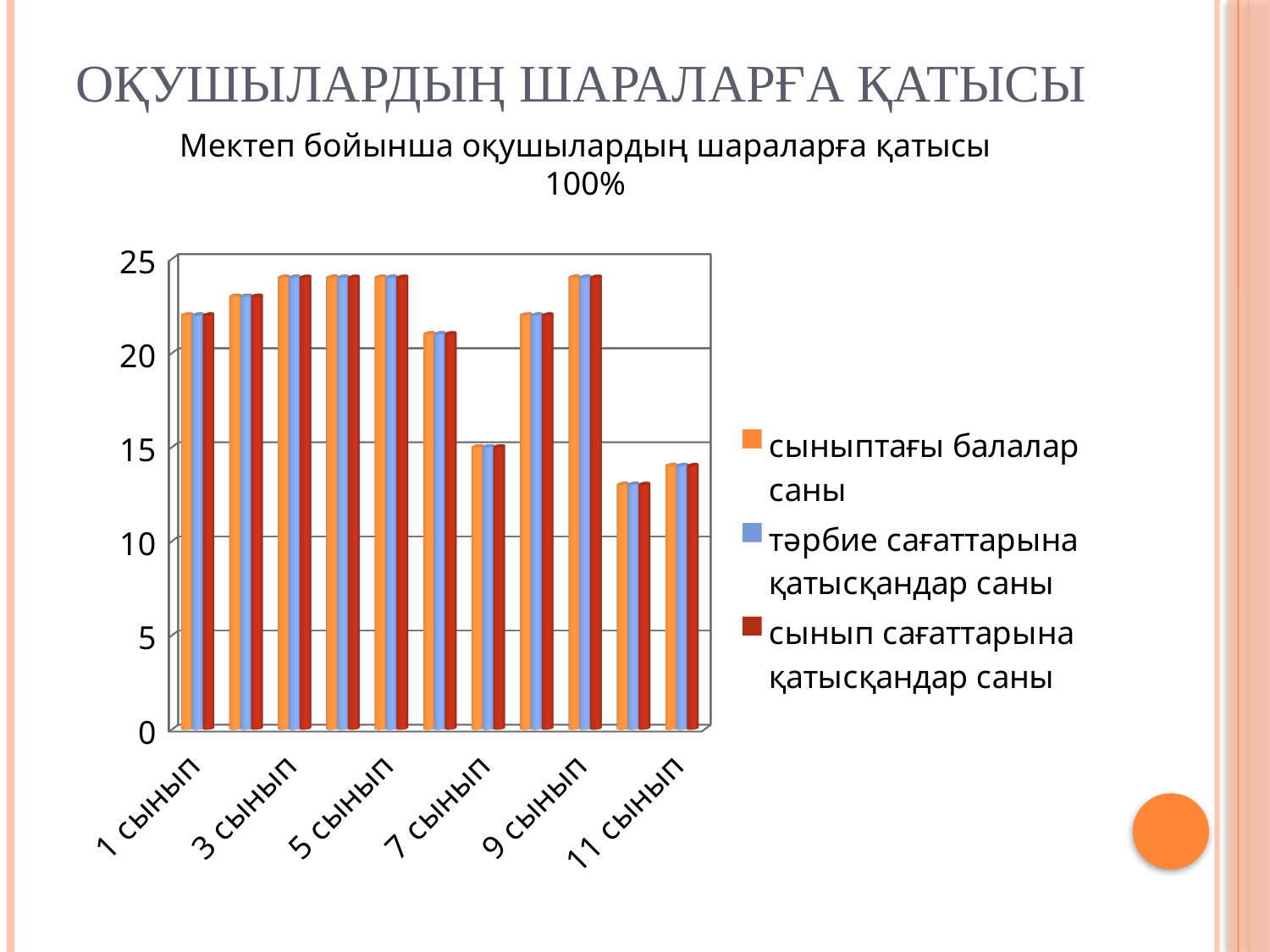
Is the value for 1 сынып greater or less than 20? greater Is the value for 7 сынып greater or less than 20? less Is the value for 9 сынып greater or less than 20? greater What kind of chart is shown on the slide? bar chart How many series does the legend list? 3 Which has the larger value, 1 сынып or 7 сынып? 1 сынып What is the first series listed in the legend? сыныптағы балалар саны Which has the larger value, 9 сынып or 11 сынып? 9 сынып How many groups of bars (categories) are plotted on the chart? 11 What is the title of the chart? Мектеп бойынша оқушылардың шараларға қатысы 100%